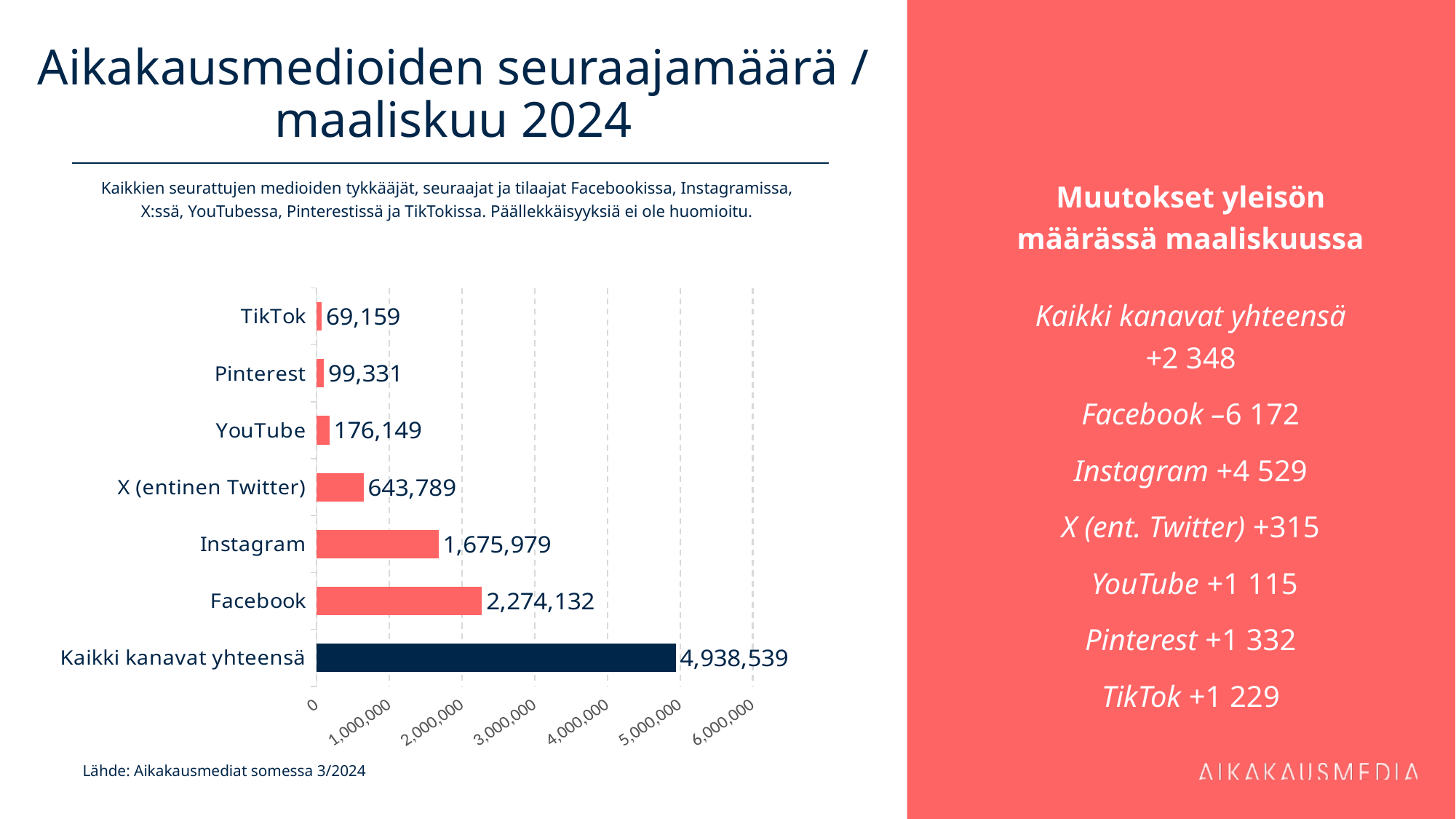
What is the value shown for X (entinen Twitter)? 643,789 What is the value shown for Kaikki kanavat yhteensä? 4,938,539 Which category has the lowest value in the chart? TikTok Excluding the total bar (Kaikki kanavat yhteensä), which channel has the highest value? Facebook What is the difference between the values for Facebook and Instagram? 598,153 What is the value shown for TikTok? 69,159 Which has a larger value, YouTube or Pinterest? YouTube What is the value shown for Instagram? 1,675,979 What kind of chart is shown on the slide? bar chart How many bars are shown in the chart? 7 What is the value shown for Facebook? 2,274,132 Is the value for Instagram greater or less than 2,000,000? less